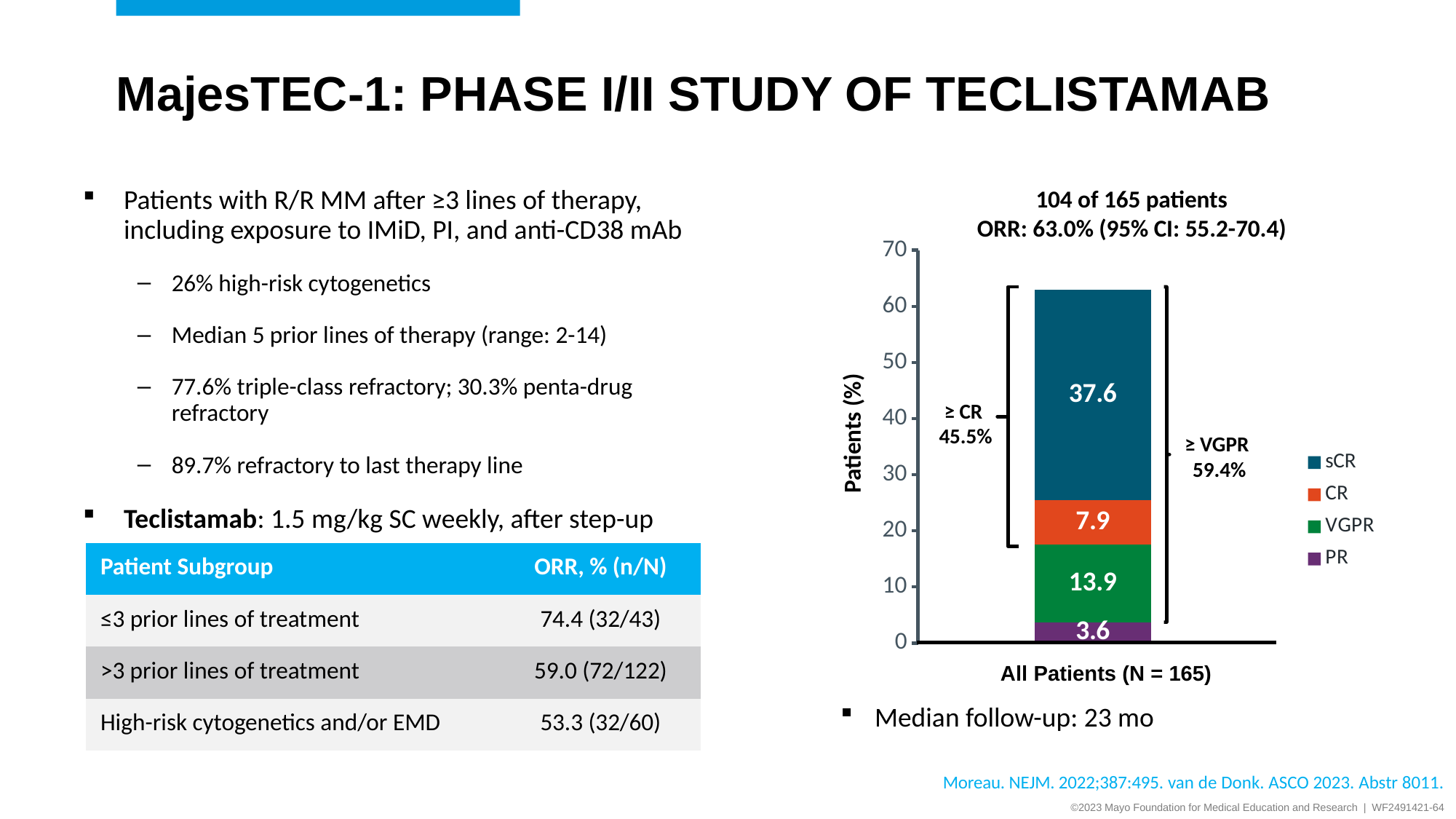
What is the value for sCR in the stacked bar? 37.6 What kind of chart is shown on the slide? Stacked bar chart Which response category has the largest segment in the stacked bar? sCR What is the difference between the sCR and VGPR values? 23.7 Which is larger, the CR value or the VGPR value? VGPR What is the value for PR in the stacked bar? 3.6 How many series does the legend list? 4 What is the value for VGPR in the stacked bar? 13.9 What is the total of the stacked bar for All Patients? 63.0 What is the value for CR in the stacked bar? 7.9 What is the label of the y axis? Patients (%) Which response category has the smallest segment in the stacked bar? PR